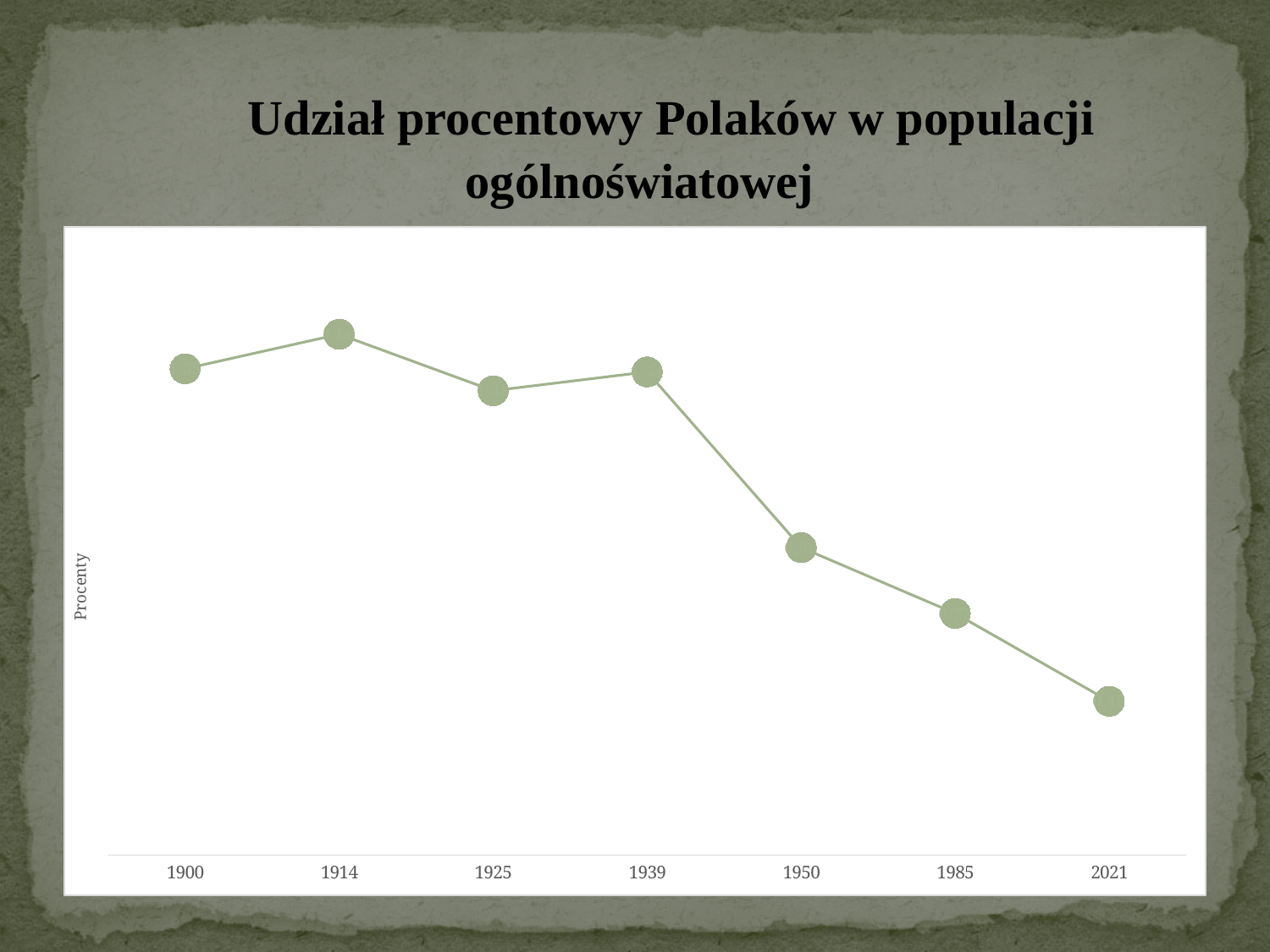
What kind of chart is shown on the slide? line chart Does the value rise or fall between 1900 and 1914? rise What is the first year shown on the x axis? 1900 In which year is the share of Poles in the world population lowest? 2021 Which year has the higher value, 1950 or 1985? 1950 Which year has the higher value, 1939 or 1950? 1939 What is the title of the chart? Udział procentowy Polaków w populacji ogólnoświatowej Which year has the higher value, 1900 or 1914? 1914 What is the label on the vertical axis? Procenty In which year is the share of Poles in the world population highest? 1914 Does the value rise or fall between 1939 and 2021? fall How many data points are plotted on the chart? 7